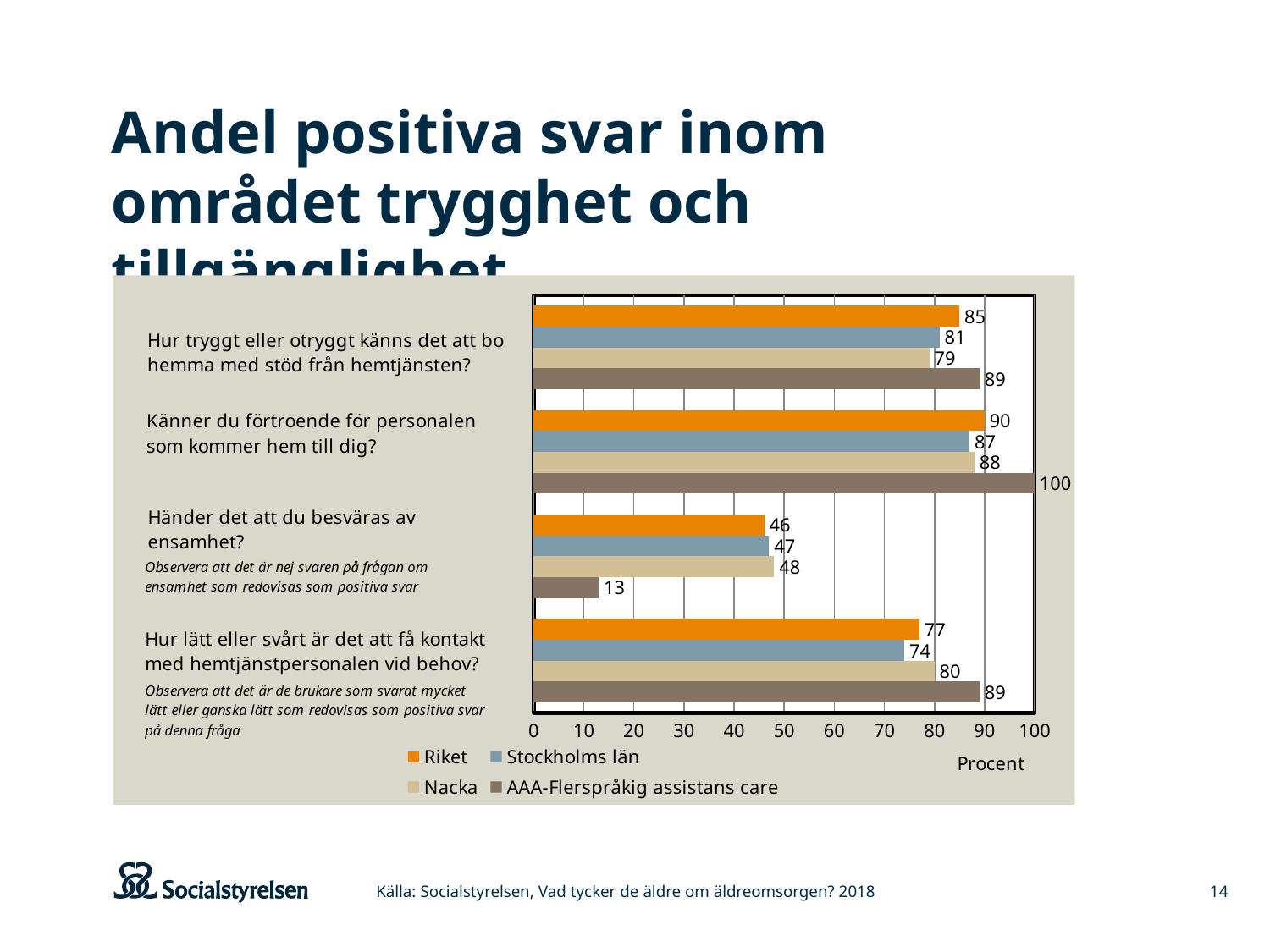
What is the difference between AAA-Flerspråkig assistans care and Riket on the question "Hur lätt eller svårt är det att få kontakt med hemtjänstpersonalen vid behov?"? 12 What unit is shown on the horizontal axis of the chart? Procent What is the value for Nacka on the question "Hur lätt eller svårt är det att få kontakt med hemtjänstpersonalen vid behov?"? 80 How many series does the legend list? 4 Which series has the highest value on the question "Känner du förtroende för personalen som kommer hem till dig?"? AAA-Flerspråkig assistans care How many questions (categories) are shown on the chart? 4 On the question "Hur tryggt eller otryggt känns det att bo hemma med stöd från hemtjänsten?", which is larger: Riket or Nacka? Riket What is the value for Stockholms län on the question "Hur tryggt eller otryggt känns det att bo hemma med stöd från hemtjänsten?"? 81 What is the value for AAA-Flerspråkig assistans care on the question "Händer det att du besväras av ensamhet?"? 13 Which series has the lowest value on the question "Händer det att du besväras av ensamhet?"? AAA-Flerspråkig assistans care What is the value for Riket on the question "Känner du förtroende för personalen som kommer hem till dig?"? 90 What kind of chart is shown on the slide? Bar chart